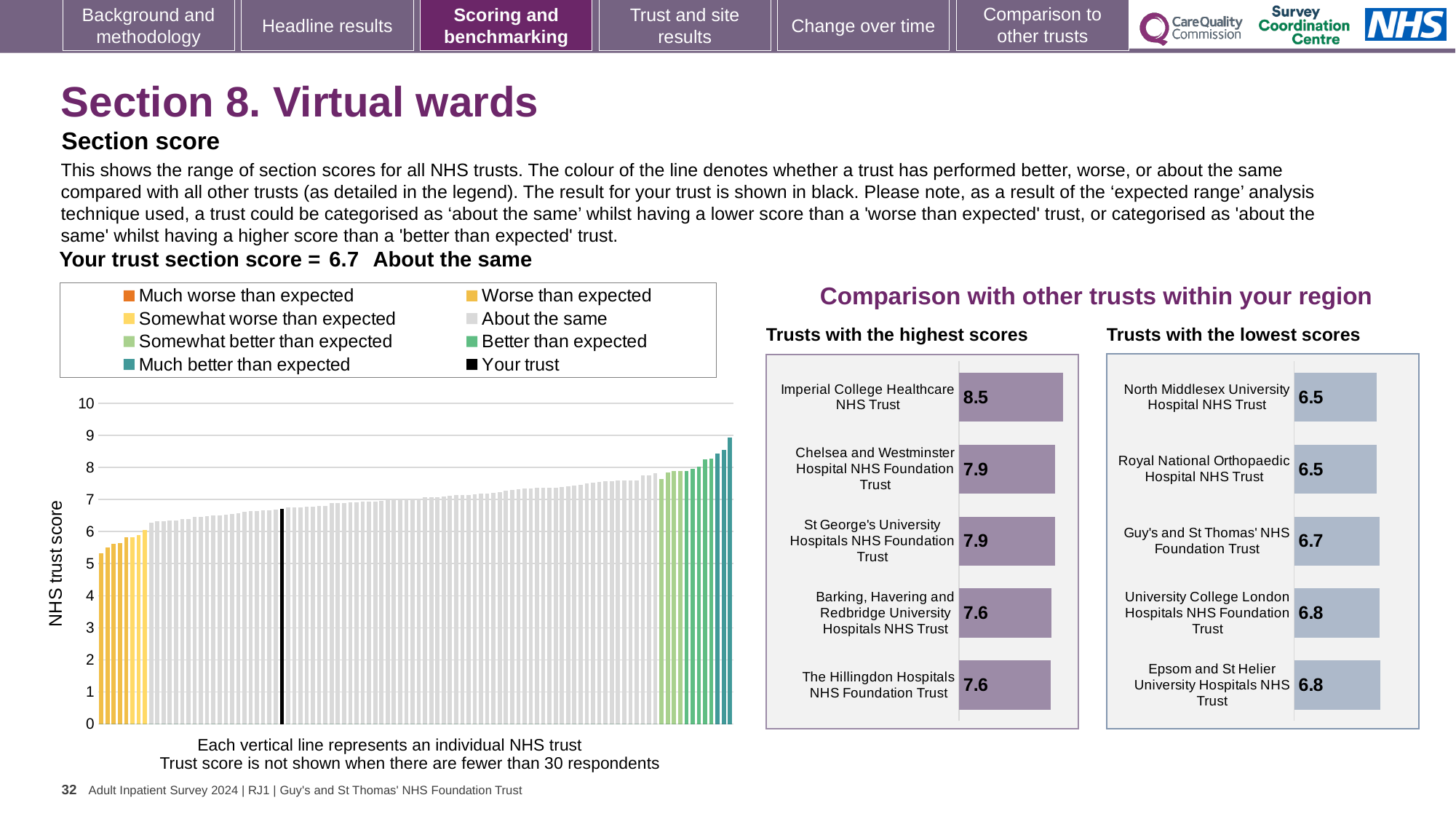
In the 'Trusts with the lowest scores' chart, what is the score for Guy's and St Thomas' NHS Foundation Trust? 6.7 In the 'Trusts with the lowest scores' chart, what is the difference between the scores of Epsom and St Helier University Hospitals NHS Trust and North Middlesex University Hospital NHS Trust? 0.3 In the 'Trusts with the highest scores' chart, what is the score for Imperial College Healthcare NHS Trust? 8.5 In the 'Trusts with the highest scores' chart, what is the difference between the scores of Imperial College Healthcare NHS Trust and The Hillingdon Hospitals NHS Foundation Trust? 0.9 In the 'Trusts with the highest scores' chart, what is the score for Barking, Havering and Redbridge University Hospitals NHS Trust? 7.6 How many trusts are shown in the 'Trusts with the lowest scores' chart? 5 In the main NHS trust score chart on the left, is the value of the black 'Your trust' bar greater or less than 7? less In the main NHS trust score chart on the left, how many entries does the legend list? 8 In the 'Trusts with the lowest scores' chart, which has the larger score: Guy's and St Thomas' NHS Foundation Trust or University College London Hospitals NHS Foundation Trust? University College London Hospitals NHS Foundation Trust In the 'Trusts with the highest scores' chart, which trust has the highest score? Imperial College Healthcare NHS Trust In the main NHS trust score chart on the left, do the bar values rise or fall from left to right? Rise What kind of chart is the main NHS trust score chart on the left? Bar chart